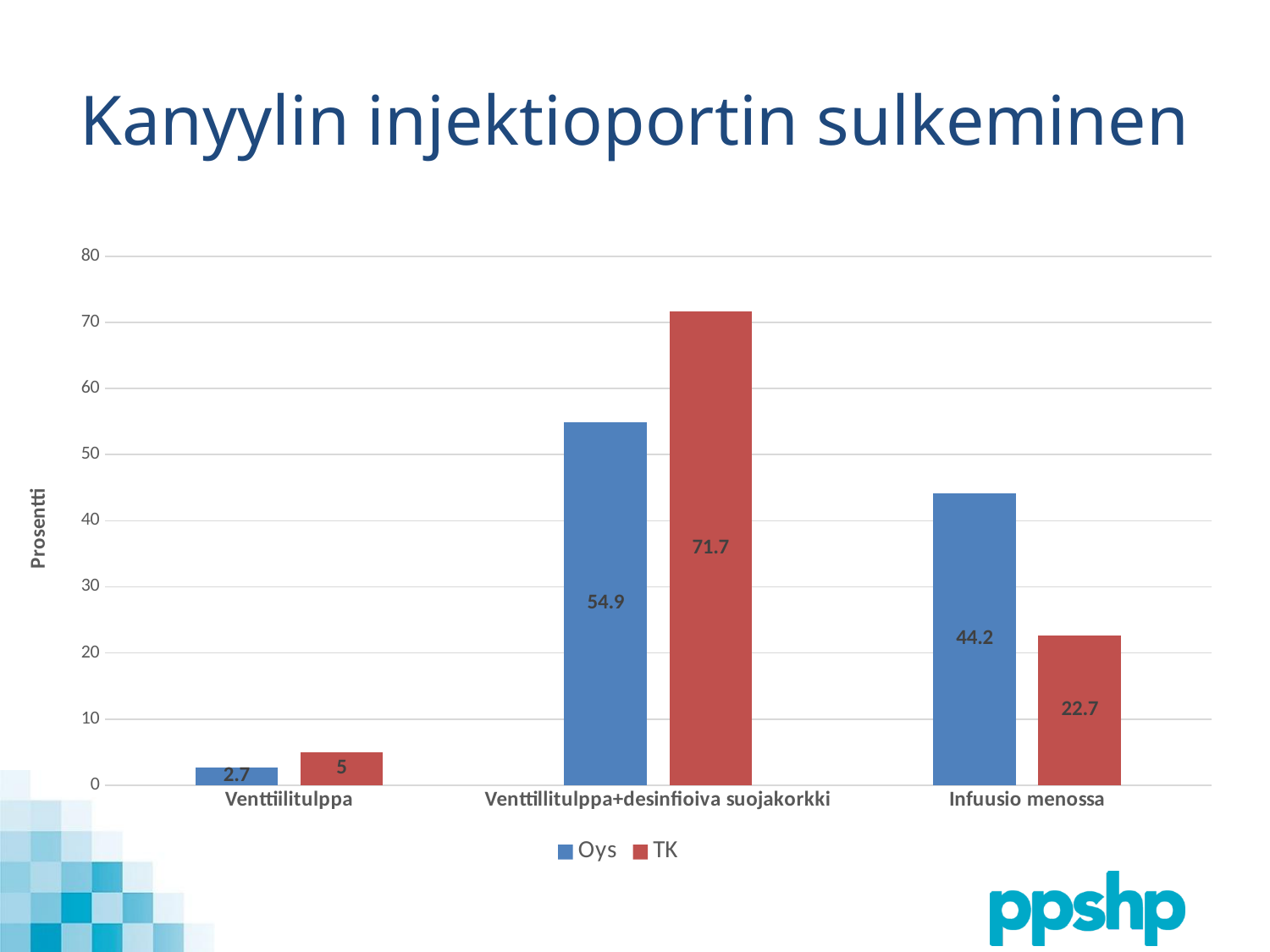
How many series does the legend list? 2 Which category has the highest value for the TK series? Venttiilitulppa+desinfioiva suojakorkki What is the difference between the TK and Oys values in the Venttiilitulppa+desinfioiva suojakorkki category? 16.8 How many categories are shown on the x axis? 3 What is the value for TK in the Infuusio menossa category? 22.7 What is the value for Oys in the Venttiilitulppa category? 2.7 Is the value for TK in the Venttiilitulppa+desinfioiva suojakorkki category greater or less than 70? greater In the Infuusio menossa category, which series has the larger value, Oys or TK? Oys What is the value for Oys in the Infuusio menossa category? 44.2 What is the value for TK in the Venttiilitulppa+desinfioiva suojakorkki category? 71.7 Which category has the lowest value for the Oys series? Venttiilitulppa What kind of chart is shown on the slide? bar chart